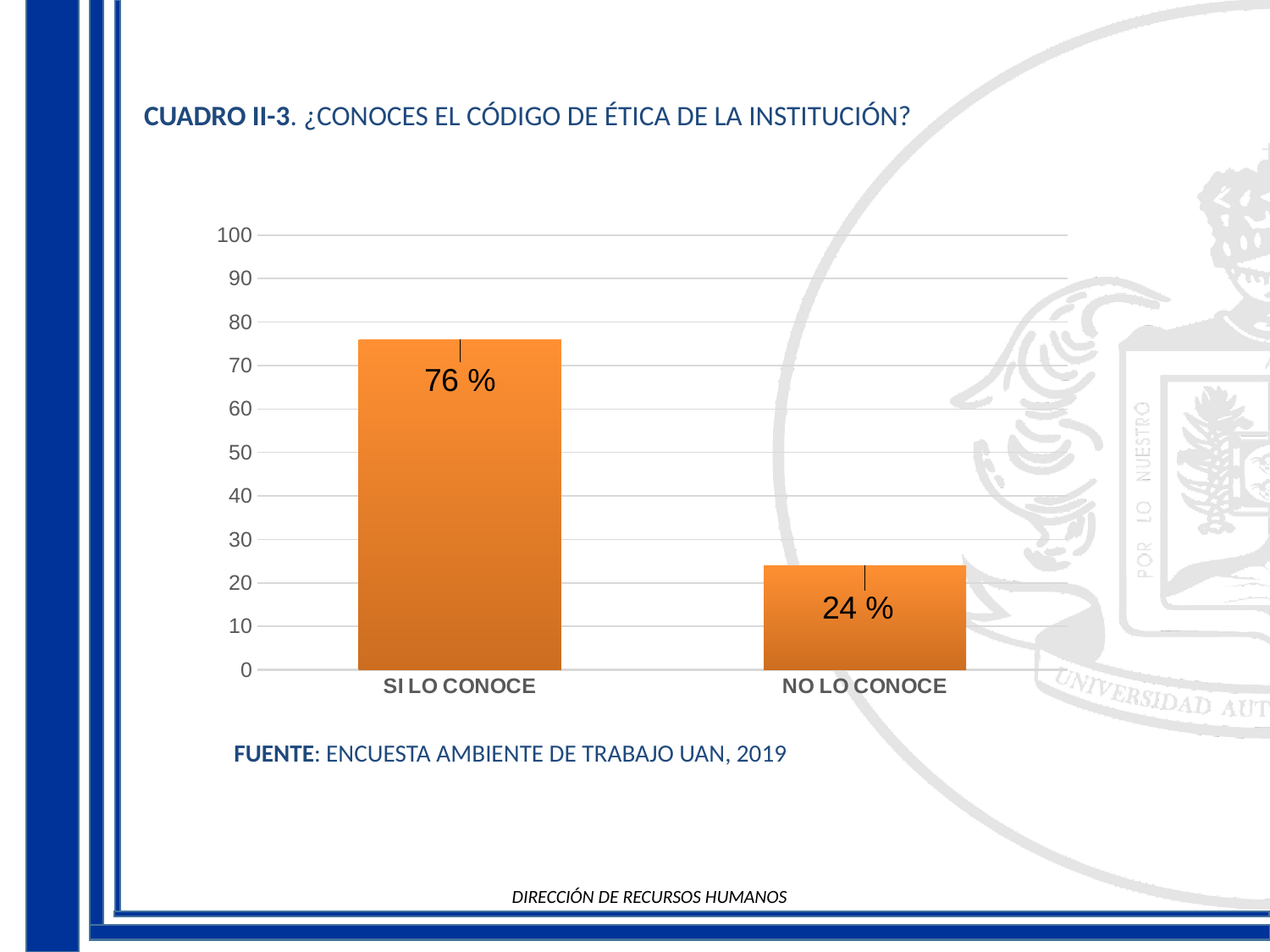
What is the value for NO LO CONOCE? 24 % How many categories are shown in the chart? 2 Which is larger, the value for SI LO CONOCE or NO LO CONOCE? SI LO CONOCE What kind of chart is shown on the slide? bar chart Is the value for SI LO CONOCE greater or less than 70? greater What is the value for SI LO CONOCE? 76 % Which category has the highest value? SI LO CONOCE What is the highest value shown on the vertical axis? 100 Which category has the lowest value? NO LO CONOCE What is the difference between the values for SI LO CONOCE and NO LO CONOCE? 52 % What is the source cited below the chart? ENCUESTA AMBIENTE DE TRABAJO UAN, 2019 Is the value for NO LO CONOCE greater or less than 30? less